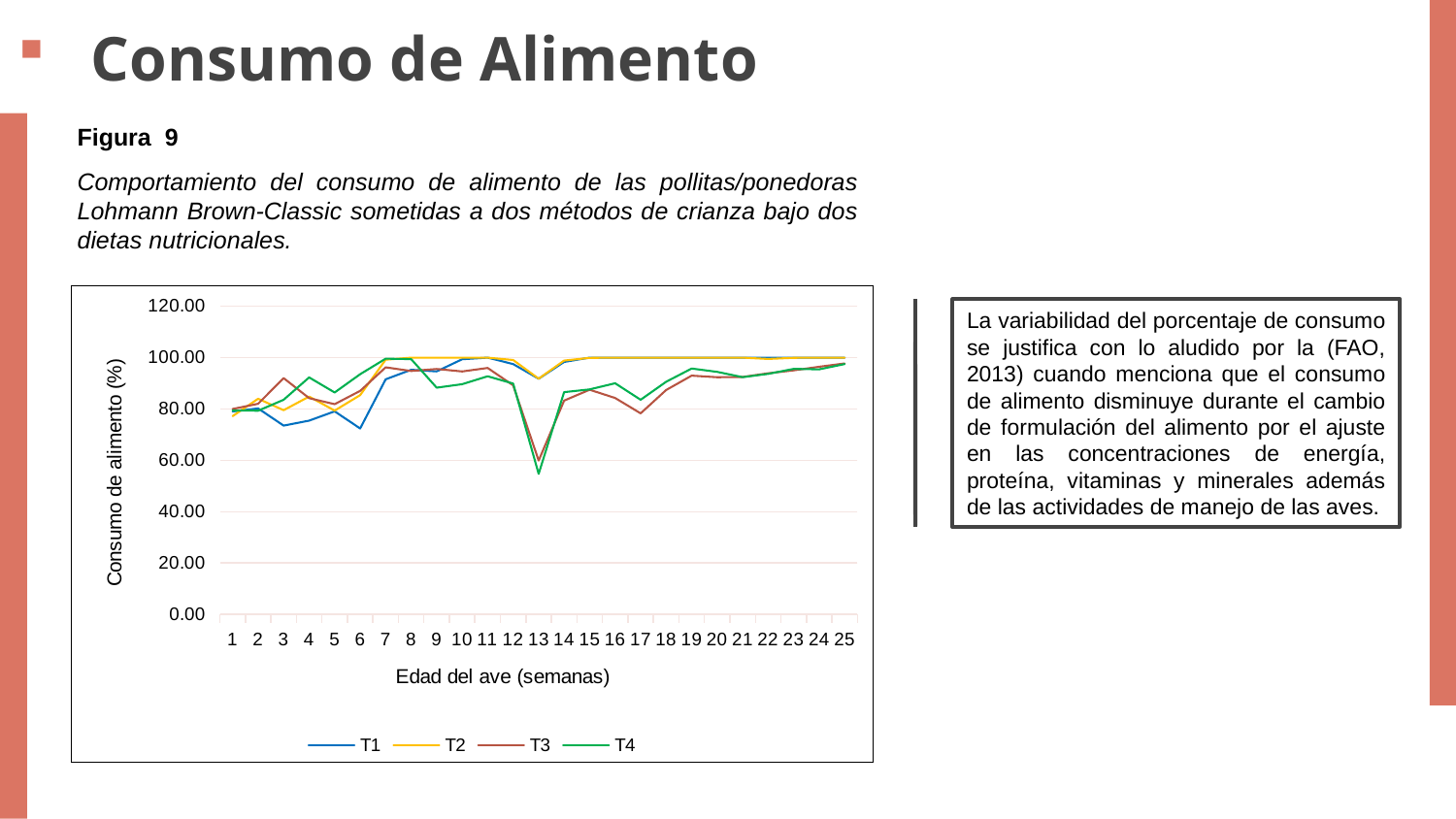
Is the value for T1 at week 6 greater or less than 80? less Is the value for T2 at week 13 greater or less than 80? greater What kind of chart is shown on the slide? line chart How many weeks (x-axis categories) are plotted on the chart? 25 How many series does the legend list? 4 Is the value for T3 at week 25 greater or less than 80? greater Which series has the lowest value at week 13? T4 What is the label of the x axis? Edad del ave (semanas) Do the values for all series rise or fall from week 13 to week 14? rise What is the label of the y axis? Consumo de alimento (%)